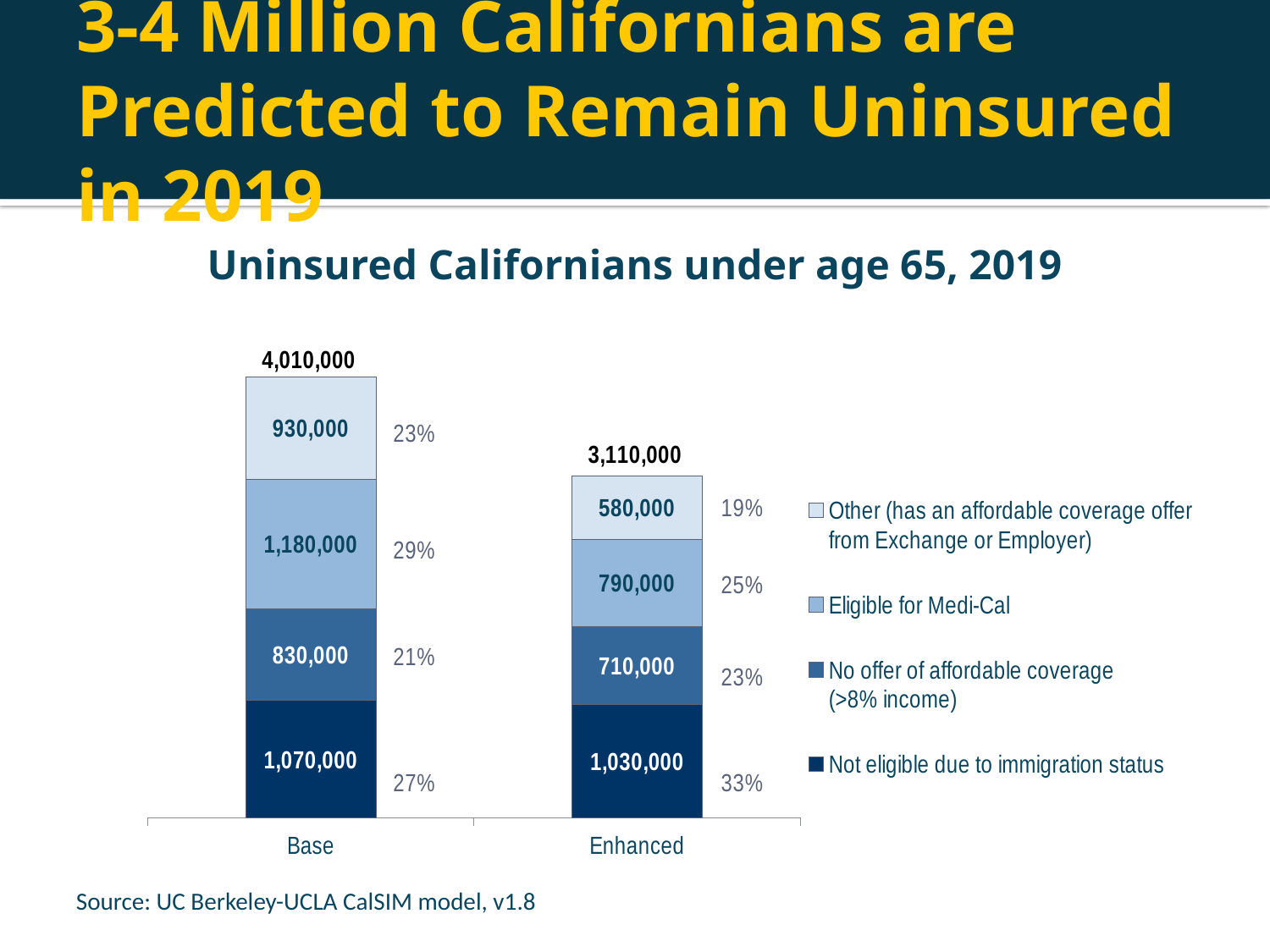
What is the total number of uninsured Californians under age 65 in the Enhanced scenario? 3,110,000 Which scenario has the larger number of people eligible for Medi-Cal, Base or Enhanced? Base Which segment is the largest in the Enhanced bar? Not eligible due to immigration status What is the title of the chart? Uninsured Californians under age 65, 2019 How many series does the legend list? 4 What kind of chart is shown on the slide? Stacked bar chart What is the difference between the Base and Enhanced totals? 900,000 How many uninsured Californians are not eligible due to immigration status in the Enhanced scenario? 1,030,000 What is the total number of uninsured Californians under age 65 in the Base scenario? 4,010,000 How many uninsured Californians are eligible for Medi-Cal in the Base scenario? 1,180,000 What percentage of the Enhanced bar is 'Other (has an affordable coverage offer from Exchange or Employer)'? 19% What percentage of the Base bar is 'No offer of affordable coverage (>8% income)'? 21%